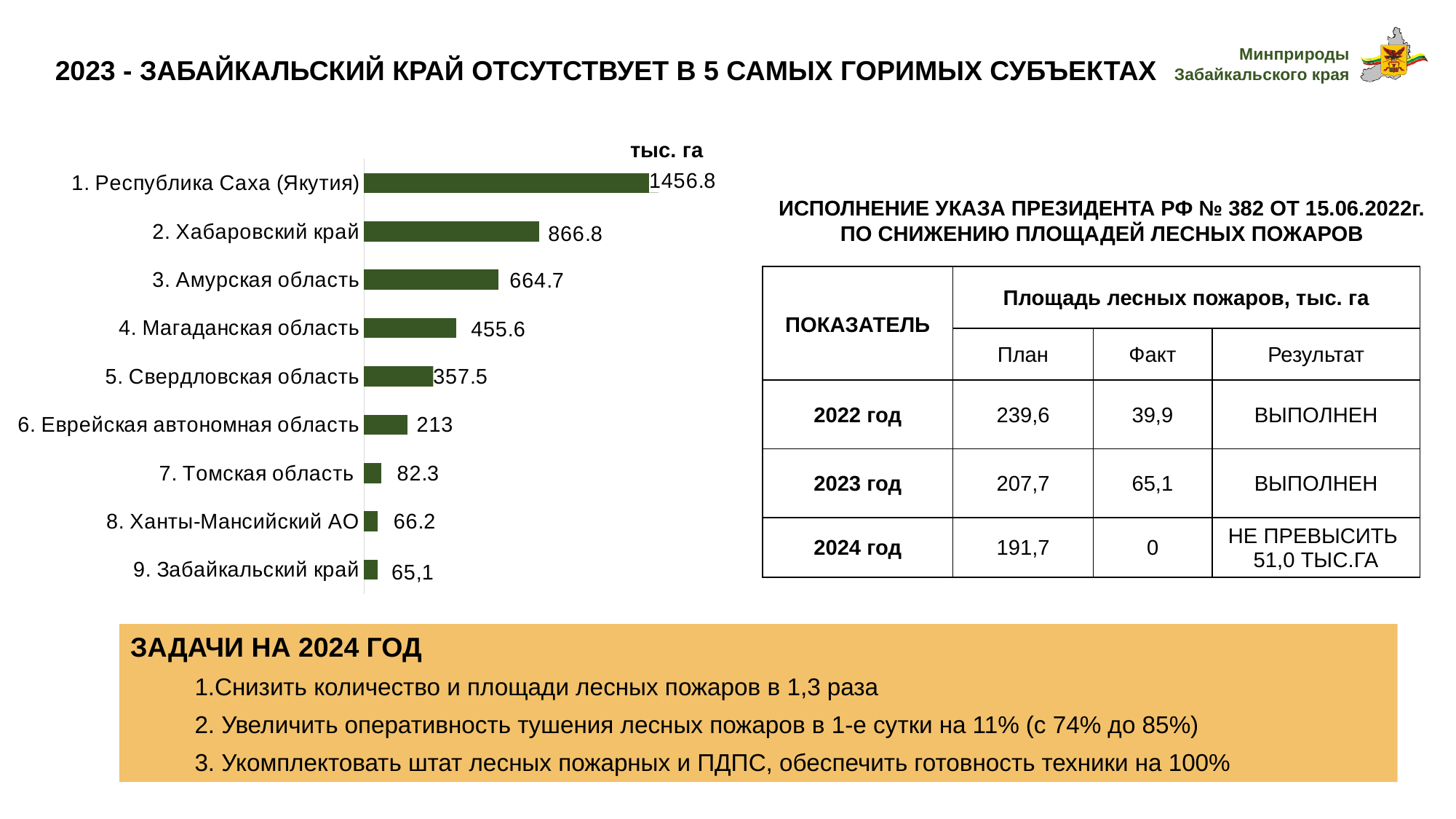
What is the difference between the values for Республика Саха (Якутия) and Хабаровский край? 590.0 Which region has the highest value in the bar chart? Республика Саха (Якутия) What is the difference between the values for Амурская область and Магаданская область? 209.1 Which region has the lowest value in the bar chart? Забайкальский край What is the value for Республика Саха (Якутия) in the bar chart? 1456.8 What unit is indicated above the bars in the chart? тыс. га What is the value for Забайкальский край in the bar chart? 65,1 What is the value for Магаданская область in the bar chart? 455.6 What is the value for Хабаровский край in the bar chart? 866.8 Which has a larger value, Свердловская область or Еврейская автономная область? Свердловская область How many regions are plotted in the bar chart? 9 What type of chart is shown on the slide? bar chart